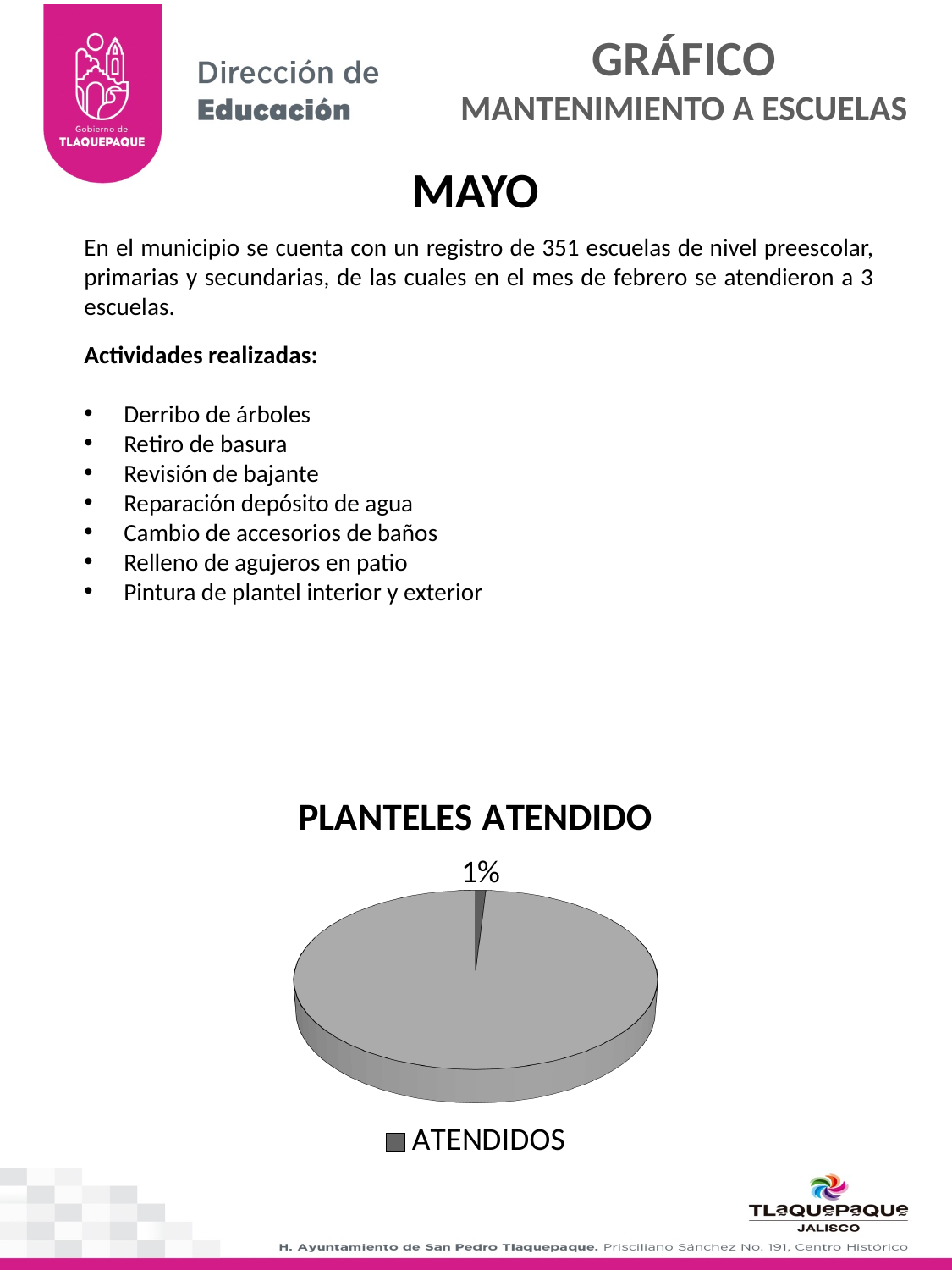
What kind of chart is shown under the title "PLANTELES ATENDIDO"? pie chart In the "PLANTELES ATENDIDO" pie chart, is the slice labelled 1% the larger or the smaller of the two slices? smaller What is the title of the chart on the slide? PLANTELES ATENDIDO How many series does the legend of the "PLANTELES ATENDIDO" chart list? 1 What is the legend entry shown below the "PLANTELES ATENDIDO" pie chart? ATENDIDOS What percentage is printed on the small slice of the "PLANTELES ATENDIDO" pie chart? 1%